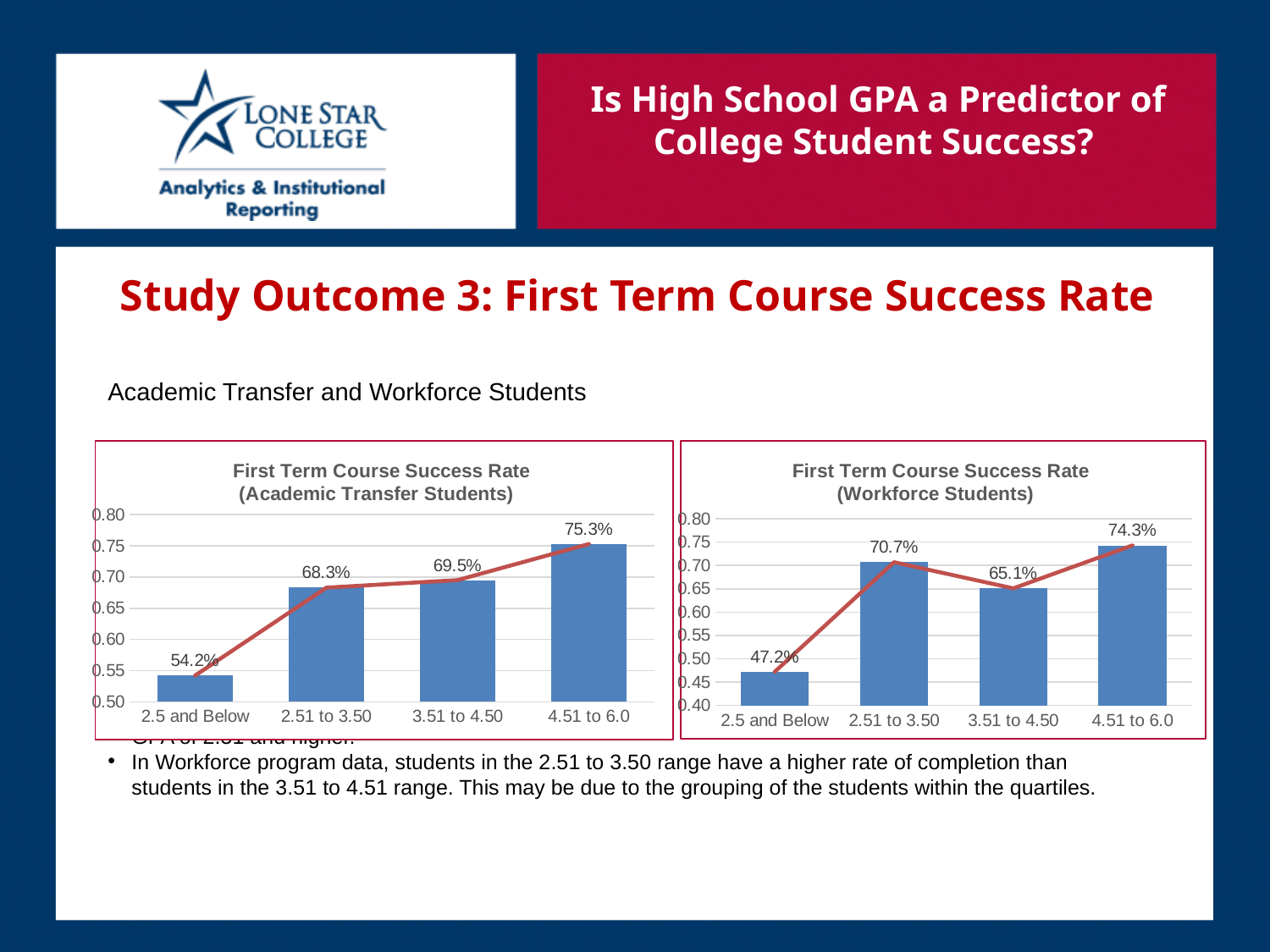
In the 'First Term Course Success Rate (Workforce Students)' chart, which category has the lowest value? 2.5 and Below In the 'First Term Course Success Rate (Academic Transfer Students)' chart, which category has the highest value? 4.51 to 6.0 In the 'First Term Course Success Rate (Academic Transfer Students)' chart, what is the value for the 2.5 and Below category? 54.2% In the 'First Term Course Success Rate (Academic Transfer Students)' chart, is the value for 2.5 and Below greater or less than 0.60? less In the 'First Term Course Success Rate (Academic Transfer Students)' chart, do the values rise or fall from 2.5 and Below to 4.51 to 6.0? rise In the 'First Term Course Success Rate (Academic Transfer Students)' chart, what is the difference between the 4.51 to 6.0 value and the 2.5 and Below value? 21.1% How many GPA categories are shown in the 'First Term Course Success Rate (Workforce Students)' chart? 4 In the 'First Term Course Success Rate (Workforce Students)' chart, which is larger: the value for 2.51 to 3.50 or the value for 3.51 to 4.50? 2.51 to 3.50 How many charts are shown on the slide? 2 In the 'First Term Course Success Rate (Workforce Students)' chart, what is the value for the 3.51 to 4.50 category? 65.1% In the 'First Term Course Success Rate (Workforce Students)' chart, what is the difference between the 2.51 to 3.50 value and the 3.51 to 4.50 value? 5.6% What kind of chart is the 'First Term Course Success Rate (Academic Transfer Students)' chart? Bar chart with a line overlay